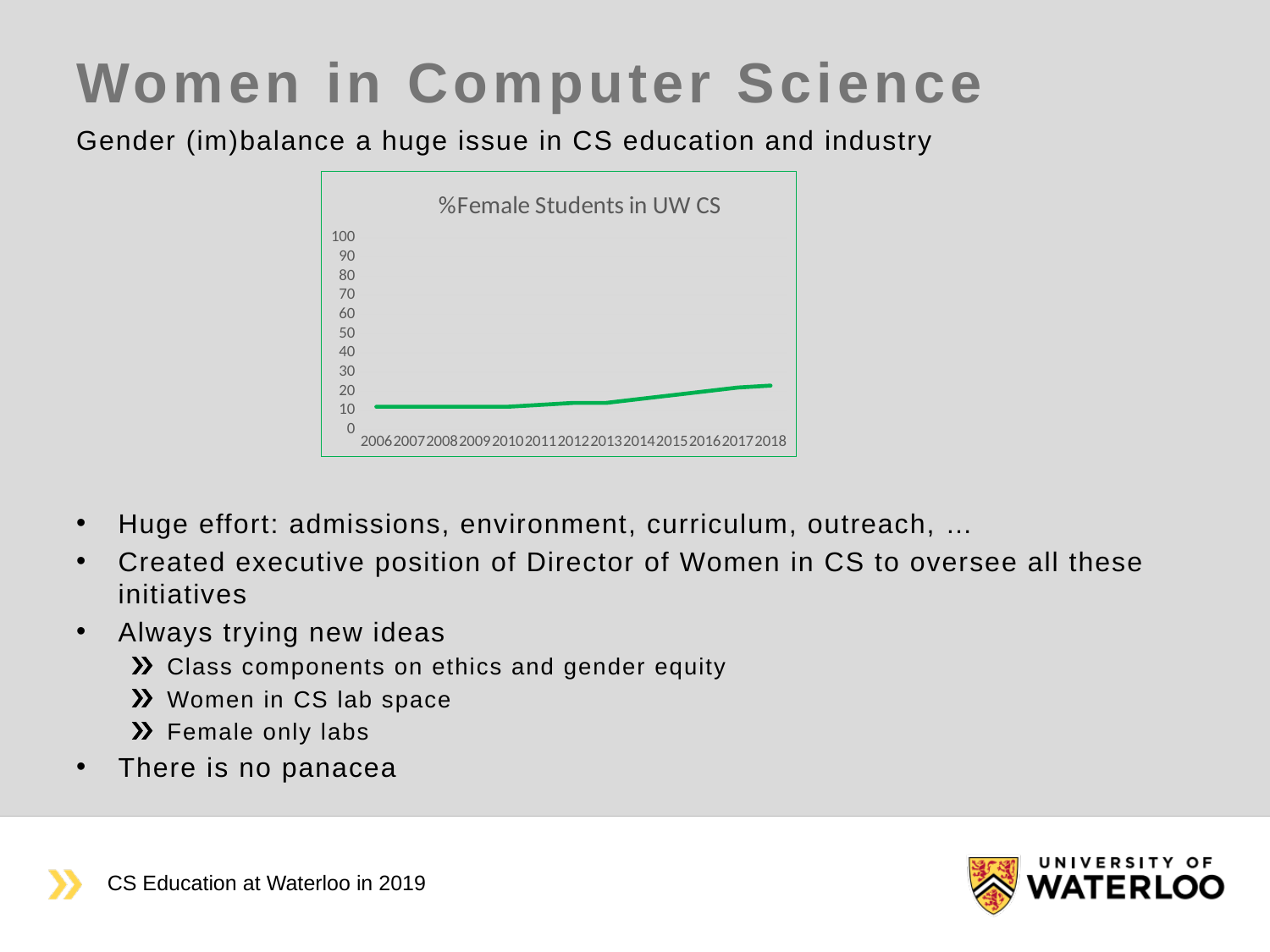
Do the values in the chart rise or fall from 2006 to 2018? rise Is the value for 2010 greater or less than 50? less Is the value for 2018 greater or less than 10? greater What is the highest value shown on the y axis of the chart? 100 Which year has the larger value, 2006 or 2018? 2018 What kind of chart is shown on the slide? line chart Which year has the highest value in the chart? 2018 What is the first year shown on the x axis of the chart? 2006 Is the value for 2018 greater or less than 30? less How many years are plotted along the x axis of the chart? 13 What is the title of the chart? %Female Students in UW CS